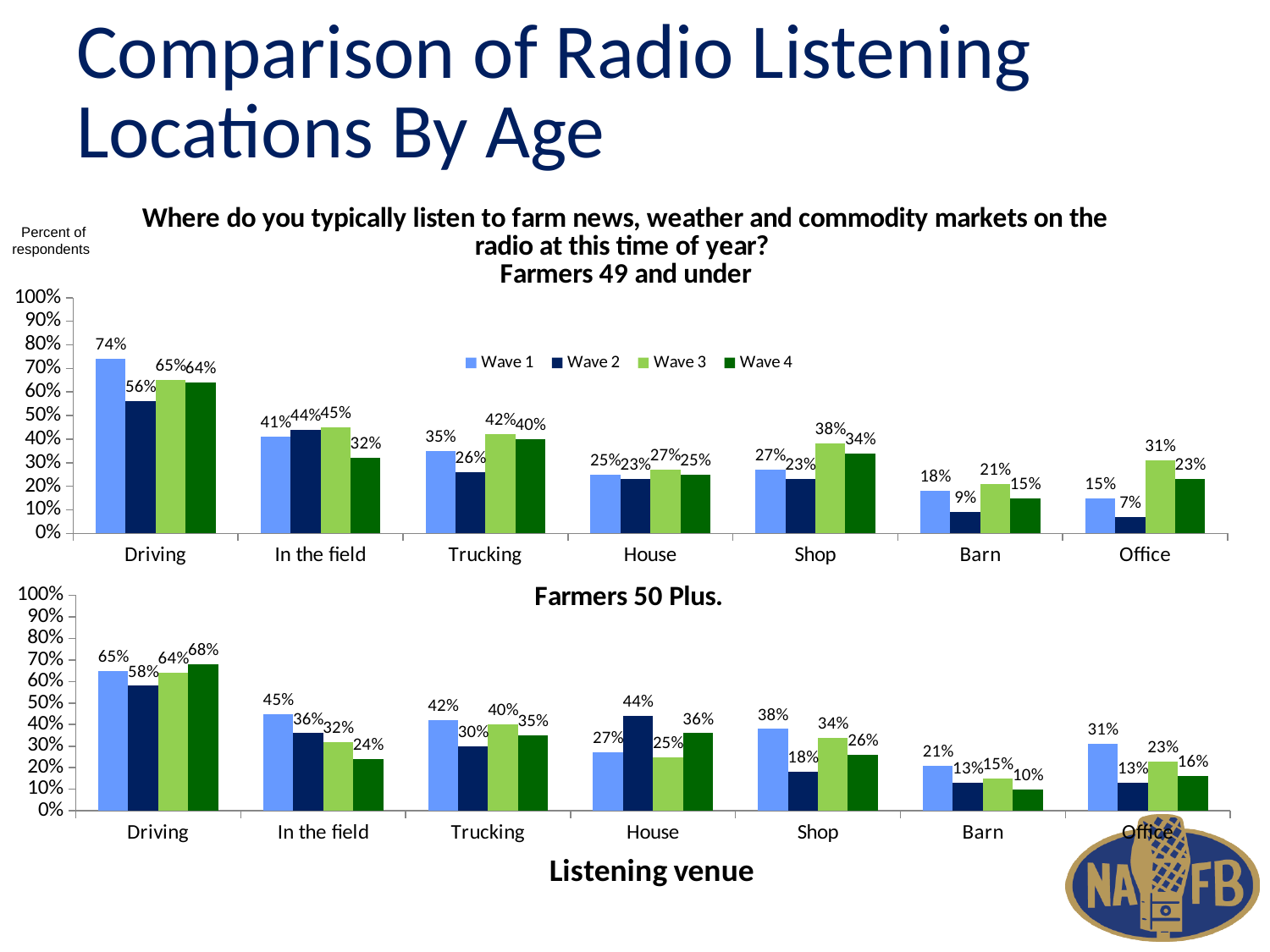
In the 'Farmers 49 and under' chart, what is the Wave 1 value for Driving? 74% In the 'Farmers 50 Plus.' chart, what is the difference between the Wave 1 and Wave 4 values for In the field? 21% In the 'Farmers 50 Plus.' chart, is the Wave 1 value for Driving greater or less than 60%? greater What kind of chart is the 'Farmers 50 Plus.' chart? Bar chart In the 'Farmers 49 and under' chart, what is the difference between the Wave 3 and Wave 2 values for Office? 24% How many series does the legend list in the 'Farmers 49 and under' chart? 4 How many listening venue categories are shown in the 'Farmers 49 and under' chart? 7 In the 'Farmers 49 and under' chart, which category has the lowest Wave 2 value? Office In the 'Farmers 49 and under' chart, which is larger for Shop: Wave 3 or Wave 4? Wave 3 In the 'Farmers 50 Plus.' chart, what is the Wave 2 value for House? 44% In the 'Farmers 50 Plus.' chart, which category has the highest Wave 4 value? Driving